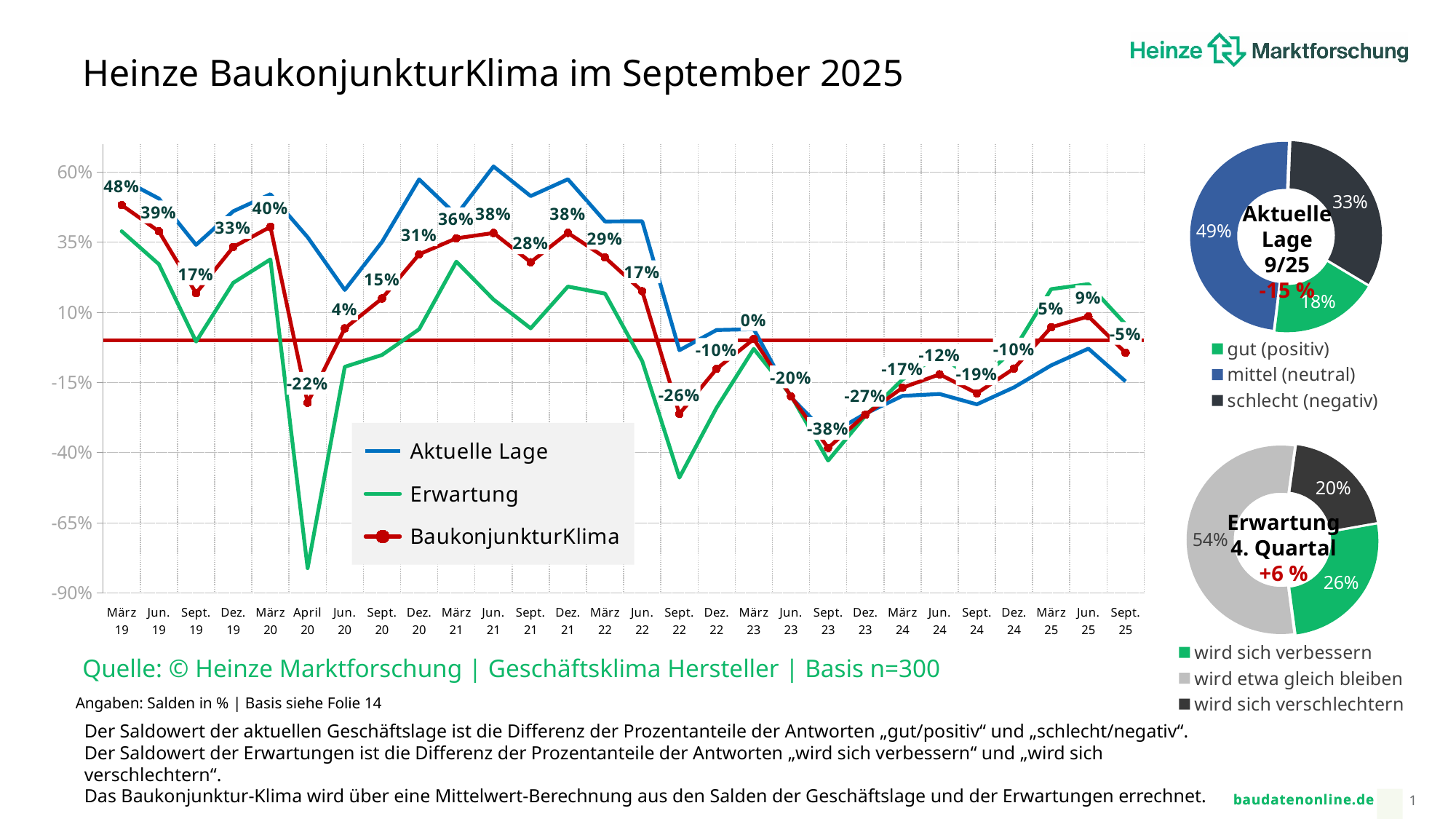
How many series does the legend of the line chart list? 3 In the line chart, is the Erwartung value for April 20 greater or less than -65%? less In the line chart, what is the BaukonjunkturKlima value for März 19? 48% In the 'Erwartung 4. Quartal' donut chart, which category has the largest share? wird etwa gleich bleiben In the line chart, is the BaukonjunkturKlima value for Sept. 22 larger or smaller than the value for Dez. 22? smaller In the line chart, which period has the lowest labelled BaukonjunkturKlima value? Sept. 23 In the line chart, what is the BaukonjunkturKlima value for Sept. 25? -5% In the 'Erwartung 4. Quartal' donut chart, what share is 'wird sich verschlechtern'? 20% In the 'Aktuelle Lage 9/25' donut chart, what share is 'mittel (neutral)'? 49% In the line chart, what is the difference between the BaukonjunkturKlima values for Jun. 25 and Sept. 25? 14 percentage points In the line chart, what is the BaukonjunkturKlima value for Sept. 23? -38% What kind of chart is the large chart on the left of the slide? line chart